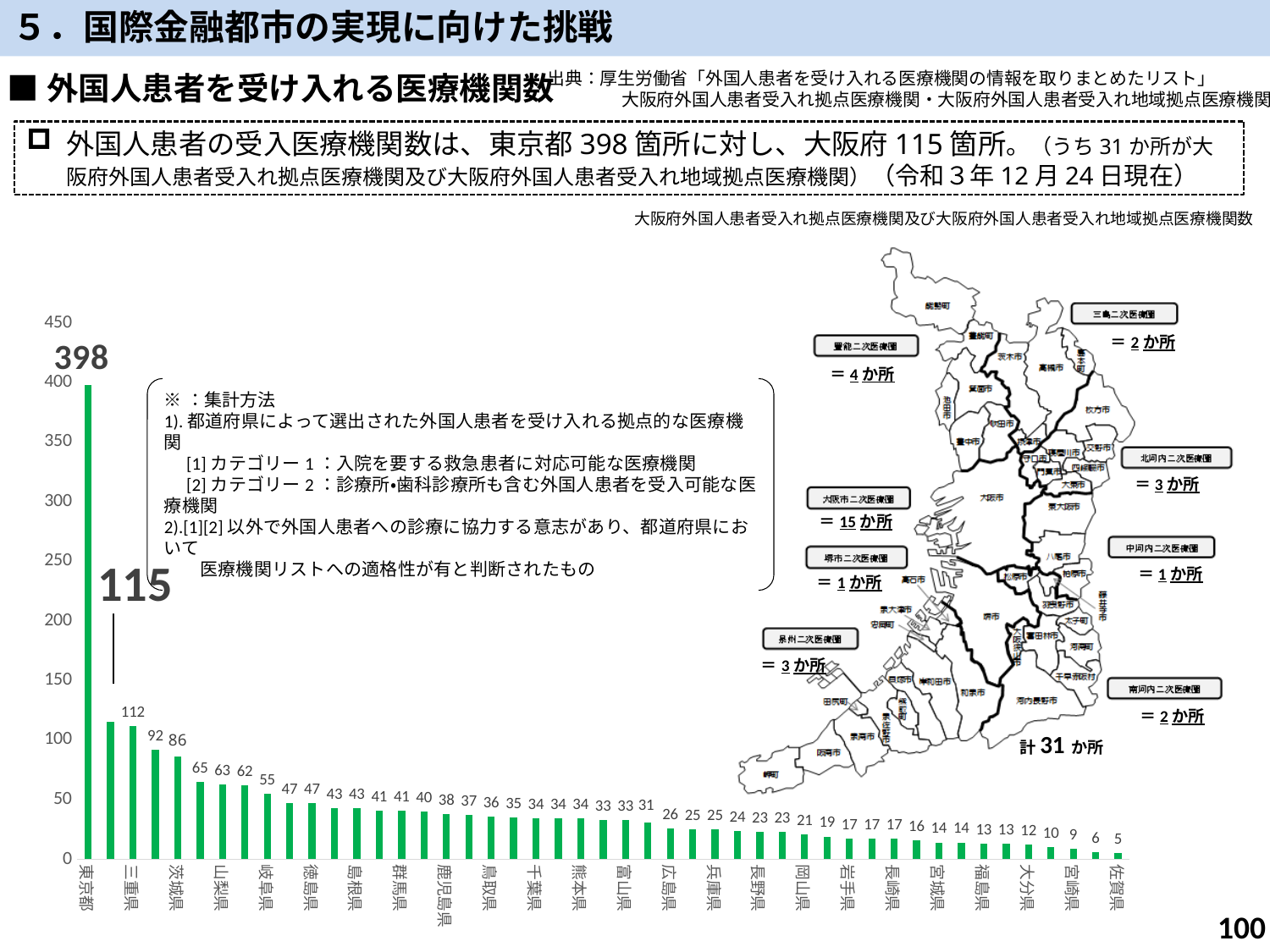
What is the value for 佐賀県 in the bar chart? 5 What is the value for 三重県 in the bar chart? 112 What is the value for 大阪府 in the bar chart? 115 Is the value for 佐賀県 greater or less than 50? less Is the value for 大阪府 greater or less than 100? greater Which prefecture has the highest bar in the chart? 東京都 What is the difference between the values for 東京都 and 大阪府? 283 Which is larger, the value for 東京都 or the value for 大阪府? 東京都 What is the value for 東京都 in the bar chart? 398 What kind of chart is shown on the slide? bar chart Do the bar values rise or fall from left to right along the x axis? fall Which prefecture has the lowest bar in the chart? 佐賀県